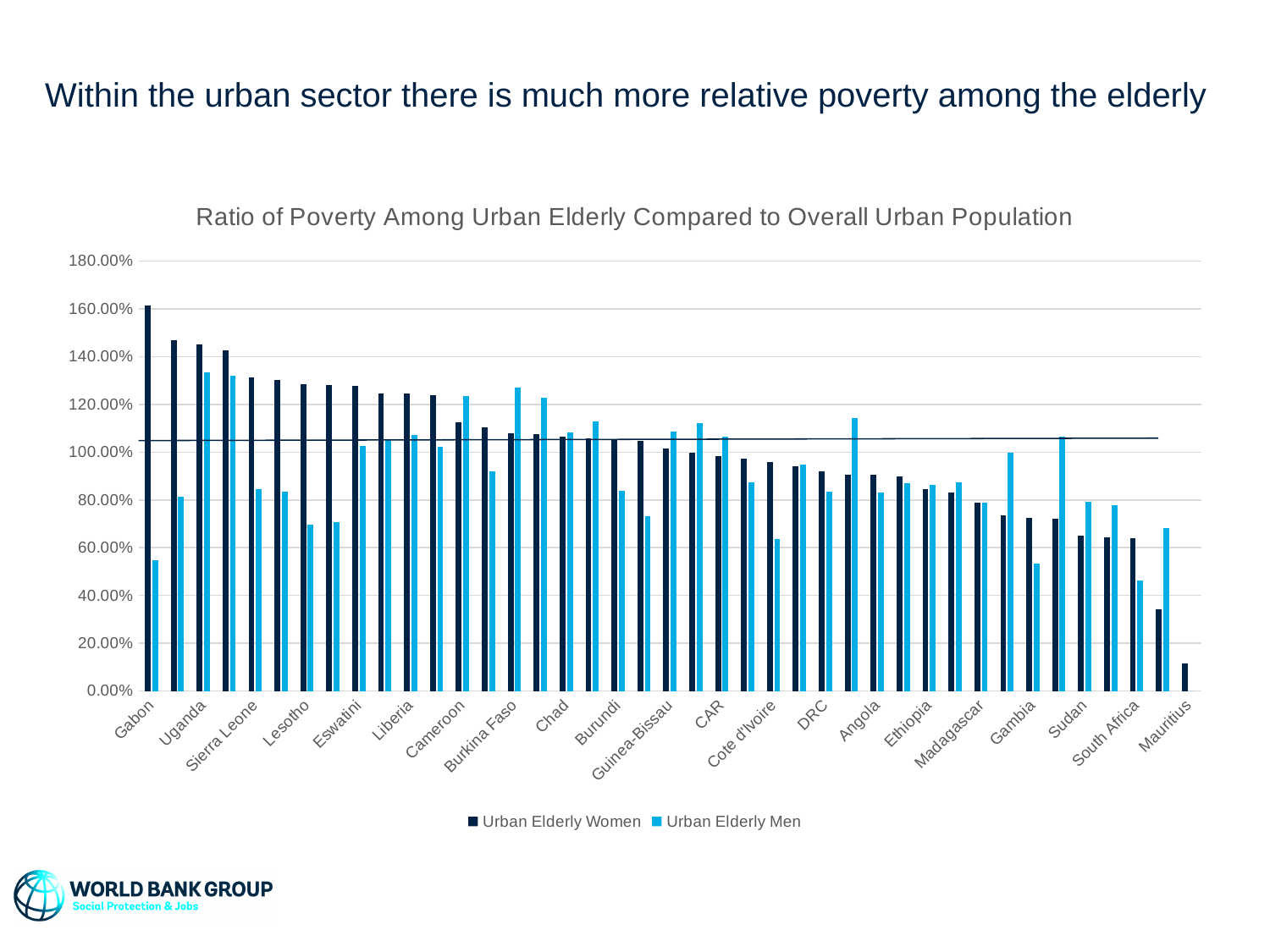
For Gabon, which is larger: the Urban Elderly Women value or the Urban Elderly Men value? Urban Elderly Women What type of chart is shown on the slide? bar chart Is the Urban Elderly Women value for Mauritius greater or less than 20.00%? less Is the Urban Elderly Men value for Uganda greater or less than 120.00%? greater Do the Urban Elderly Women values generally rise or fall moving from left to right across the countries? fall Which country has the highest value for Urban Elderly Women? Gabon What are the two series named in the legend? Urban Elderly Women and Urban Elderly Men How many series does the legend list? 2 Which country has the lowest value for Urban Elderly Women? Mauritius What is the title of the chart? Ratio of Poverty Among Urban Elderly Compared to Overall Urban Population Is the Urban Elderly Women value for Gabon greater or less than 140.00%? greater